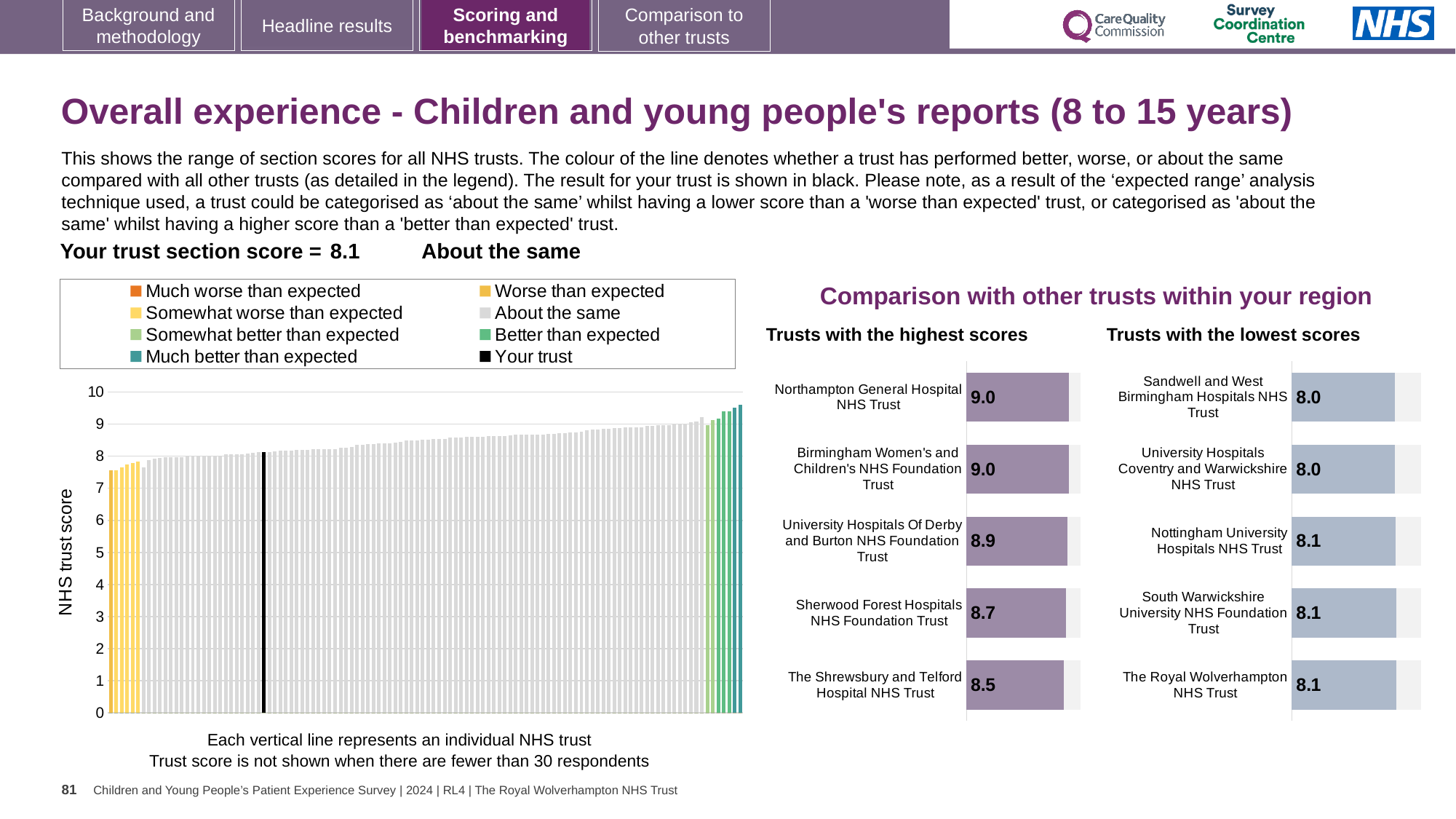
How many entries does the legend of the main chart on the left list? 8 In the 'Trusts with the highest scores' chart, which has the larger score: Sherwood Forest Hospitals NHS Foundation Trust or The Shrewsbury and Telford Hospital NHS Trust? Sherwood Forest Hospitals NHS Foundation Trust In the 'Trusts with the highest scores' chart, what is the score for Northampton General Hospital NHS Trust? 9.0 In the 'Trusts with the highest scores' chart, which trust has the lowest score? The Shrewsbury and Telford Hospital NHS Trust How many trusts are listed in the 'Trusts with the lowest scores' chart? 5 In the 'Trusts with the highest scores' chart, what is the score for Sherwood Forest Hospitals NHS Foundation Trust? 8.7 In the main chart on the left showing the range of section scores, what kind of chart is it? Bar chart In the 'Trusts with the highest scores' chart, what is the difference between the scores of Northampton General Hospital NHS Trust and The Shrewsbury and Telford Hospital NHS Trust? 0.5 In the 'Trusts with the lowest scores' chart, what is the score for The Royal Wolverhampton NHS Trust? 8.1 In the 'Trusts with the lowest scores' chart, what is the score for Sandwell and West Birmingham Hospitals NHS Trust? 8.0 In the main chart on the left, what is the label of the vertical axis? NHS trust score In the main chart on the left, do the trust scores rise or fall from left to right? Rise